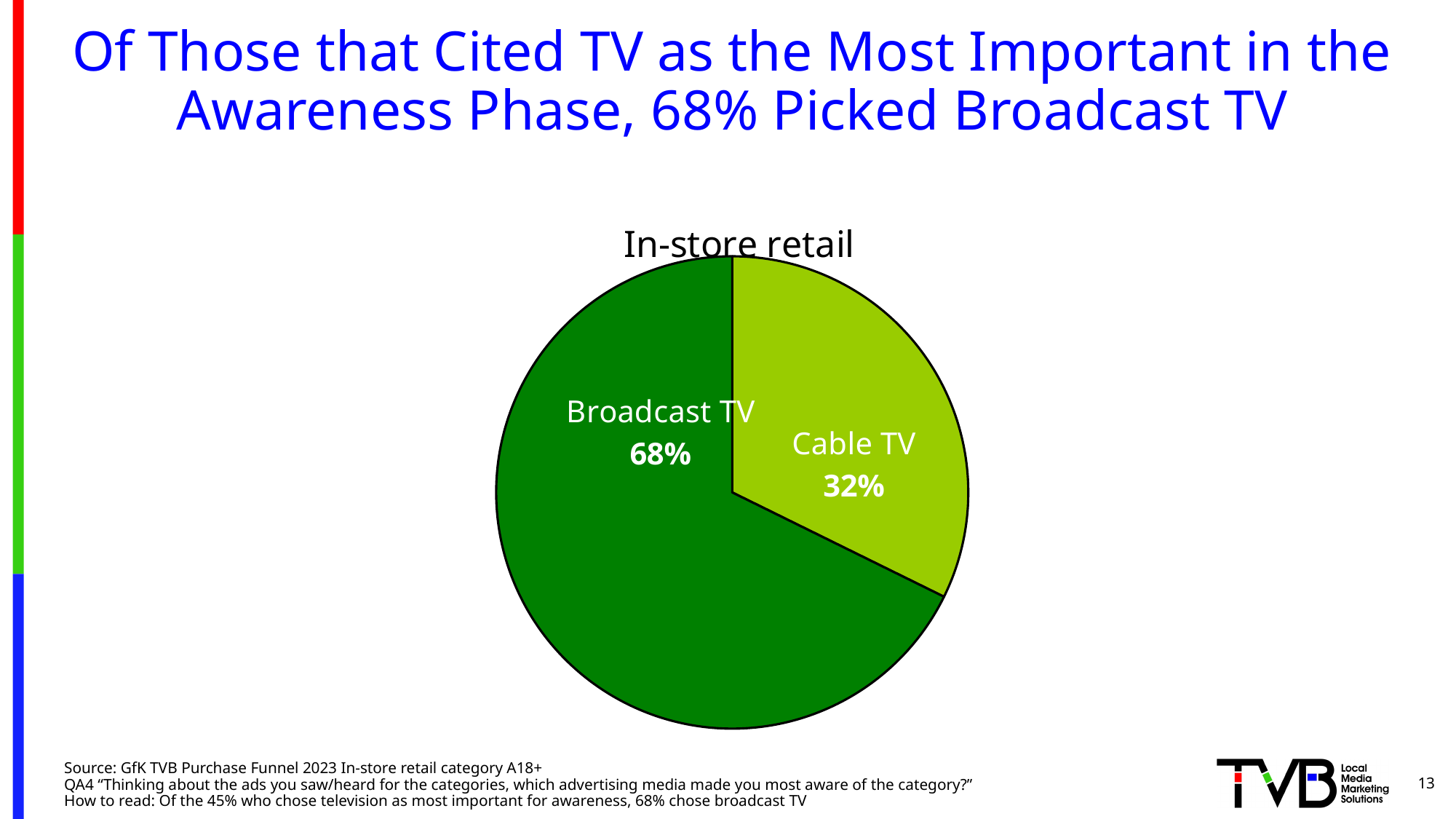
What colour is the Cable TV slice? Light green What is the title of the chart? In-store retail What share of the pie does Broadcast TV hold? 68% Which slice of the pie is the largest? Broadcast TV How many slices does the pie chart have? 2 What share of the pie does Cable TV hold? 32% What is the total of the two slices shown in the pie chart? 100% What kind of chart is shown on the slide? Pie chart Which is larger, the Broadcast TV slice or the Cable TV slice? Broadcast TV What is the difference in percentage points between the Broadcast TV and Cable TV slices? 36 percentage points Which slice of the pie is the smallest? Cable TV